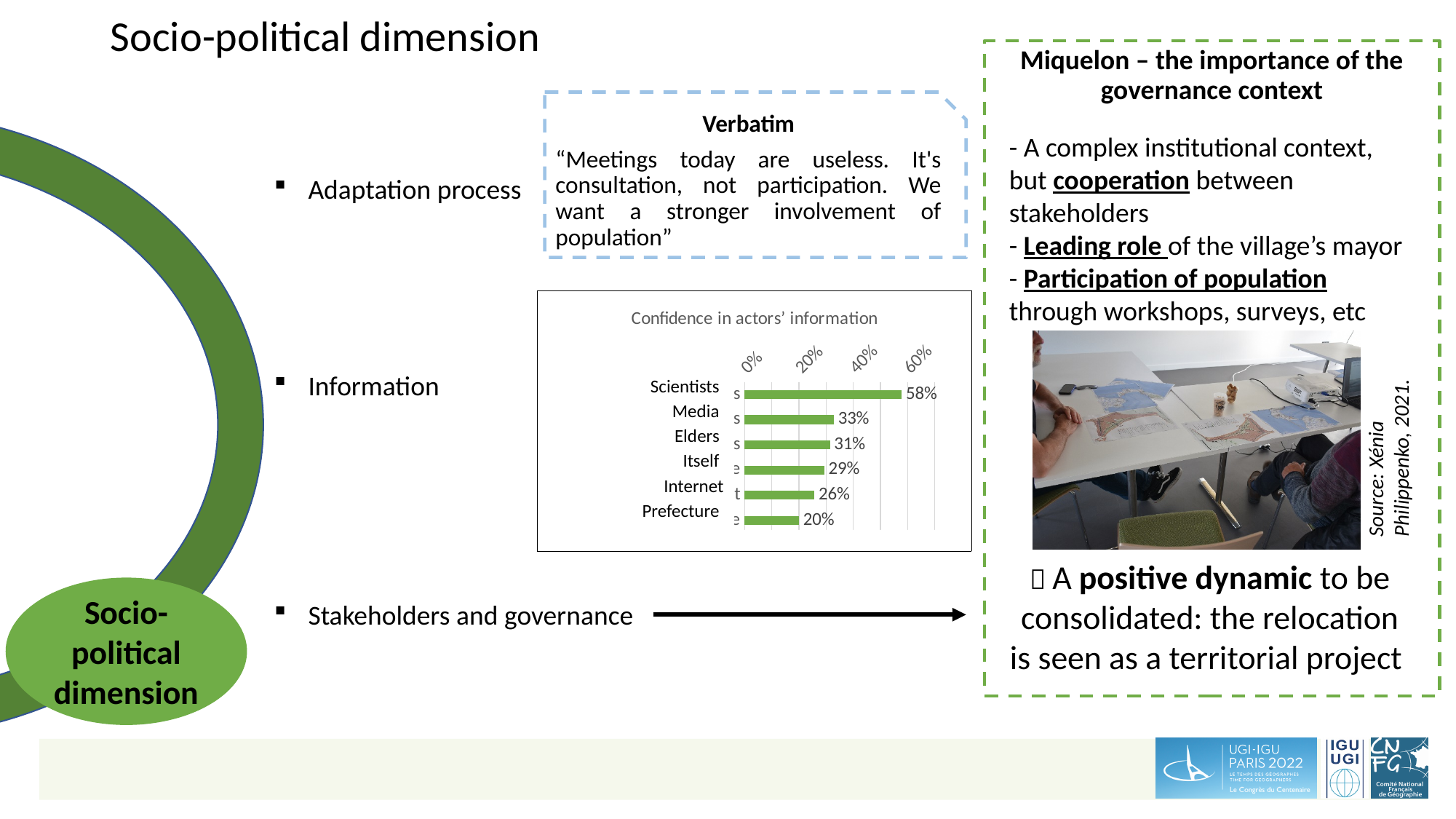
What is the value for Internet in the 'Confidence in actors' information' chart? 26% What kind of chart is 'Confidence in actors' information'? bar chart What is the title of the chart on the slide? Confidence in actors' information What is the value for Scientists in the 'Confidence in actors' information' chart? 58% Which category has the highest value in the 'Confidence in actors' information' chart? Scientists Which category has the lowest value in the 'Confidence in actors' information' chart? Prefecture What is the value for Prefecture in the 'Confidence in actors' information' chart? 20% What is the value for Media in the 'Confidence in actors' information' chart? 33% How many categories are shown in the 'Confidence in actors' information' chart? 6 What is the difference between the values for Scientists and Media in the 'Confidence in actors' information' chart? 25% Which has a larger value in the 'Confidence in actors' information' chart, Elders or Itself? Elders What is the difference between the values for Itself and Prefecture in the 'Confidence in actors' information' chart? 9%